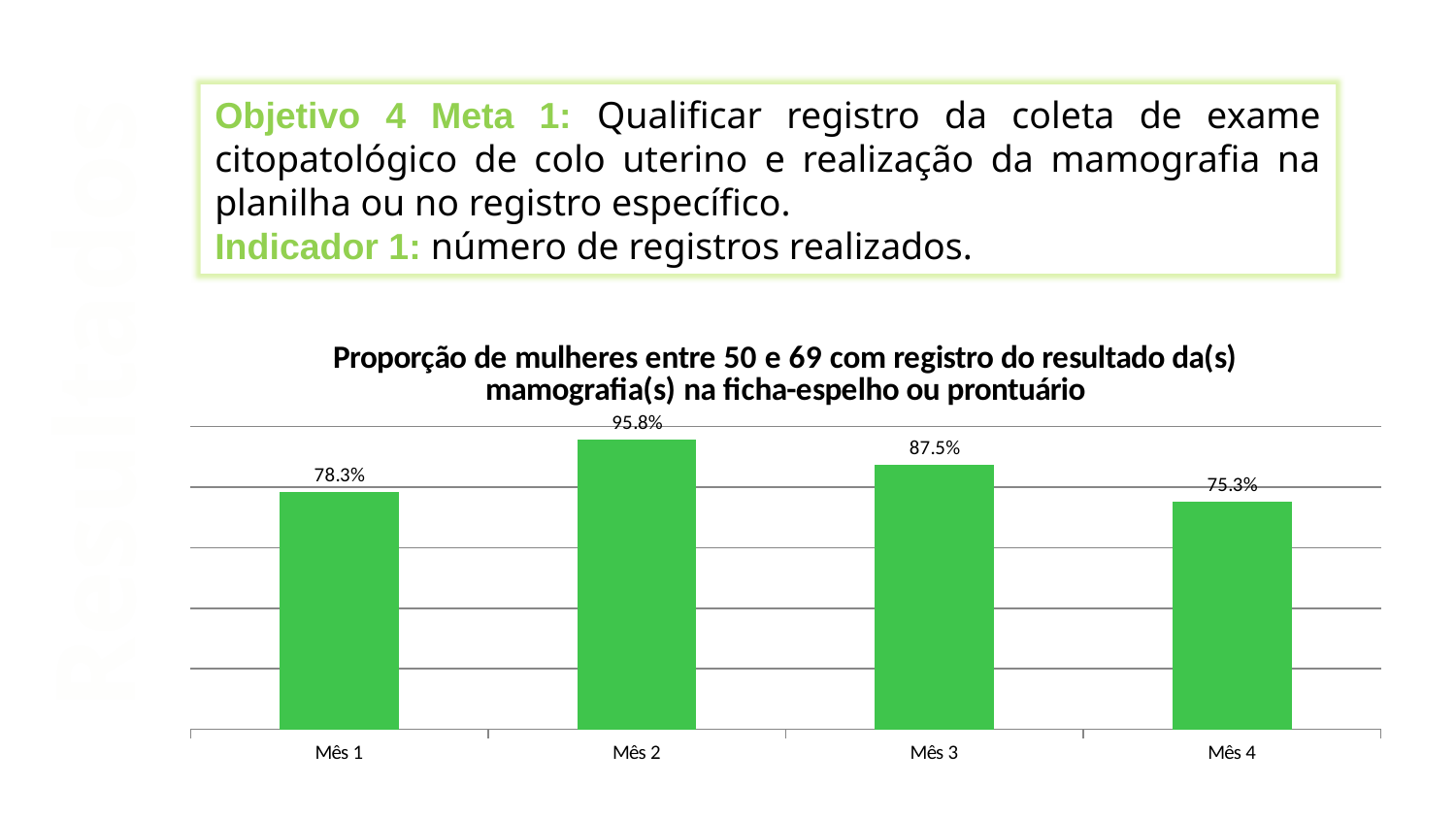
What is the title of the chart? Proporção de mulheres entre 50 e 69 com registro do resultado da(s) mamografia(s) na ficha-espelho ou prontuário Which month has the lowest value? Mês 4 What is the value for Mês 2? 95.8% What is the value for Mês 4? 75.3% How many months are shown on the x axis? 4 Which month has the highest value? Mês 2 What is the difference between the values for Mês 3 and Mês 4? 12.2% What is the difference between the values for Mês 2 and Mês 1? 17.5% What kind of chart is shown on the slide? Bar chart Which is larger, the value for Mês 1 or the value for Mês 3? Mês 3 What is the value for Mês 1? 78.3% What is the value for Mês 3? 87.5%